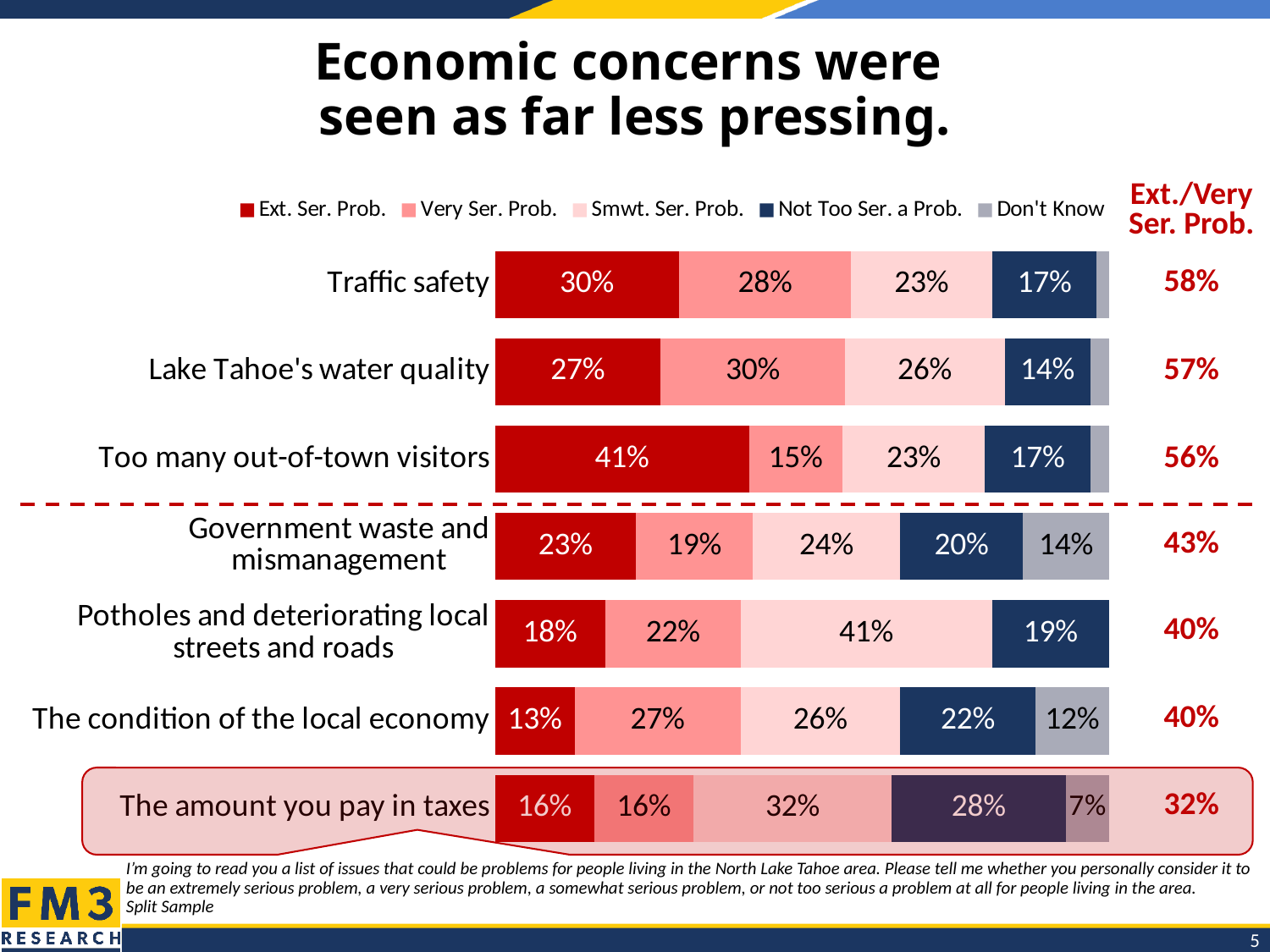
What is the 'Very Ser. Prob.' value for Lake Tahoe's water quality? 30% What is the 'Don't Know' value for the condition of the local economy? 12% How many series does the legend list? 5 Which issue has the highest 'Ext. Ser. Prob.' value? Too many out-of-town visitors What percentage of respondents rated traffic safety as an extremely serious problem? 30% What is the combined total of the 'Ext. Ser. Prob.' and 'Very Ser. Prob.' segments for Lake Tahoe's water quality? 57% How many issues are listed in the chart? 7 Which issue has the lowest 'Ext. Ser. Prob.' value? The condition of the local economy What kind of chart is shown on the slide? Stacked bar chart What is the combined Ext./Very Ser. Prob. figure shown for the amount you pay in taxes? 32% Which is larger: the 'Not Too Ser. a Prob.' value for the amount you pay in taxes or for government waste and mismanagement? The amount you pay in taxes What is the difference between the 'Smwt. Ser. Prob.' values for potholes and deteriorating local streets and roads and for traffic safety? 18%